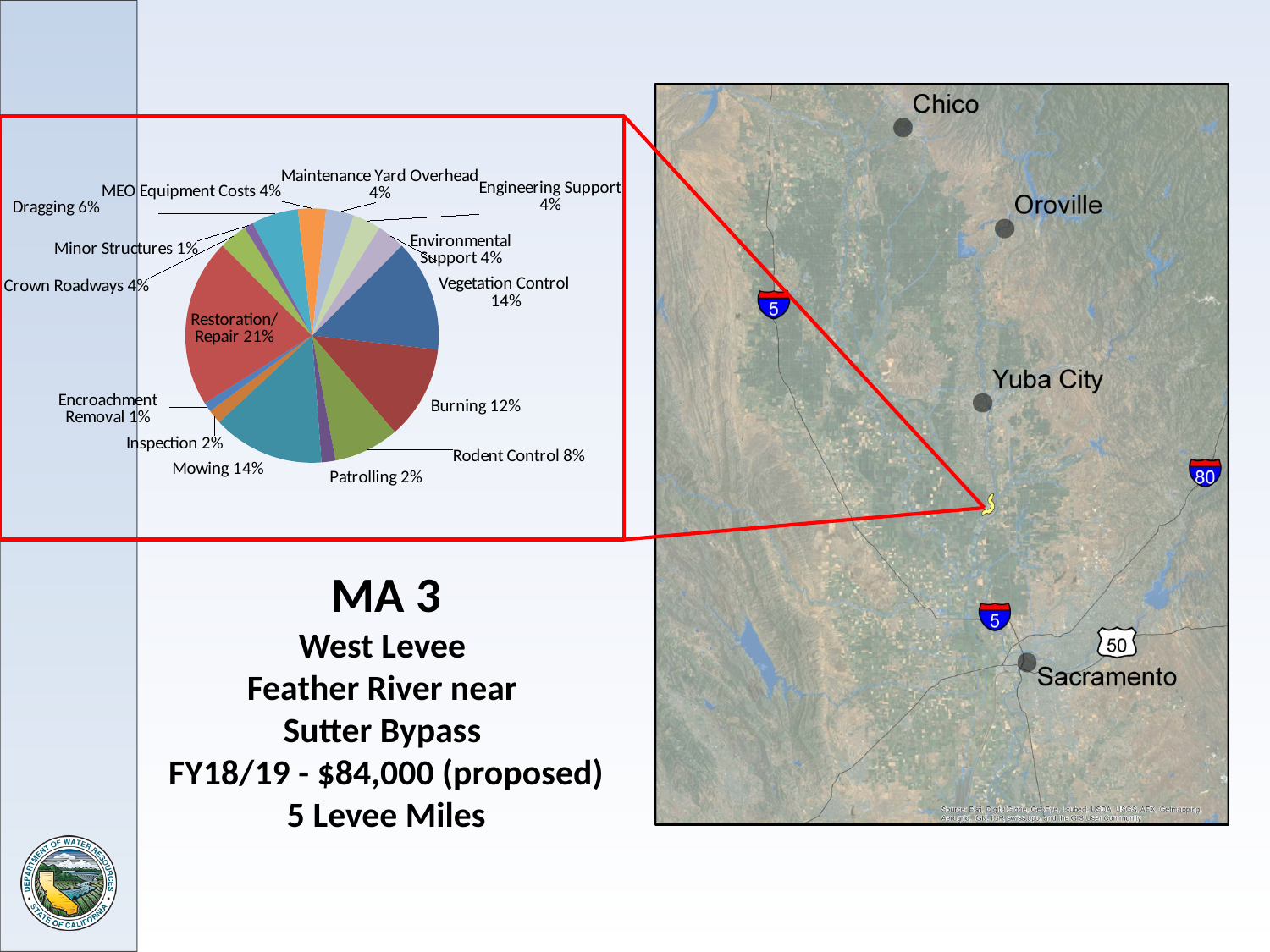
What type of chart is shown on the slide? pie chart Which is larger, the slice for Burning or the slice for Rodent Control? Burning Which category has the largest slice of the pie? Restoration/Repair What is the difference in percentage points between Burning and Dragging? 6 What percentage is shown for Dragging? 6% What percentage is shown for Inspection? 2% What percentage is shown for Vegetation Control? 14% What percentage is shown for Rodent Control? 8% What percentage is shown for Burning? 12% What is the difference in percentage points between Restoration/Repair and Mowing? 7 What share of the pie does Restoration/Repair account for? 21% How many categories are shown in the pie chart? 15